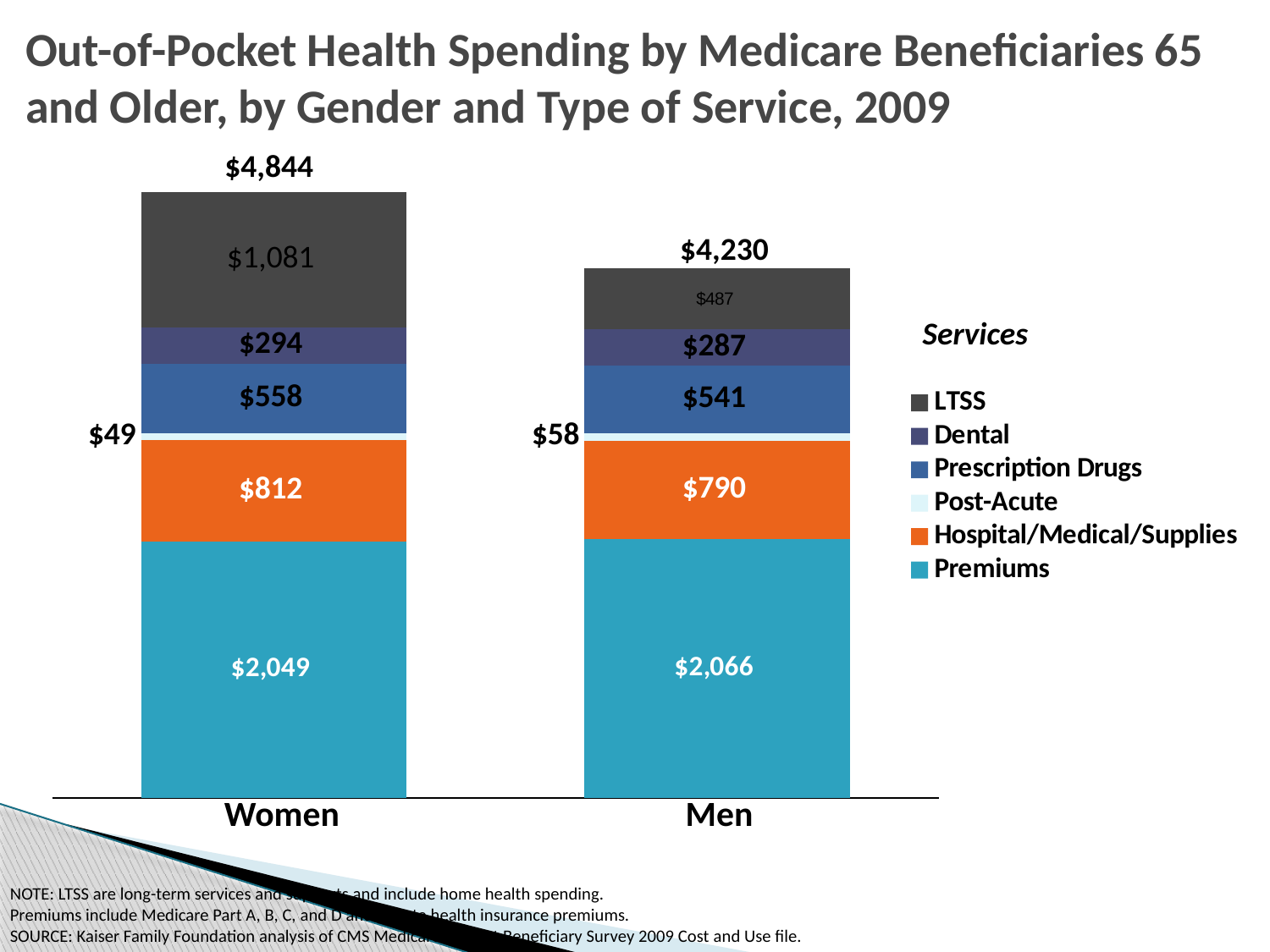
What is the total out-of-pocket spending for Men? $4,230 How many categories are shown on the x axis? 2 Which gender has the higher Hospital/Medical/Supplies value? Women Which category has the higher total out-of-pocket spending? Women What is the LTSS value for Women? $1,081 What is the total out-of-pocket spending for Women? $4,844 What type of chart is shown on the slide? Stacked bar chart What is the title of the legend? Services What is the Premiums value for Men? $2,066 How many series does the legend list? 6 What is the difference between the LTSS values for Women and Men? $594 What is the Post-Acute value for Women? $49